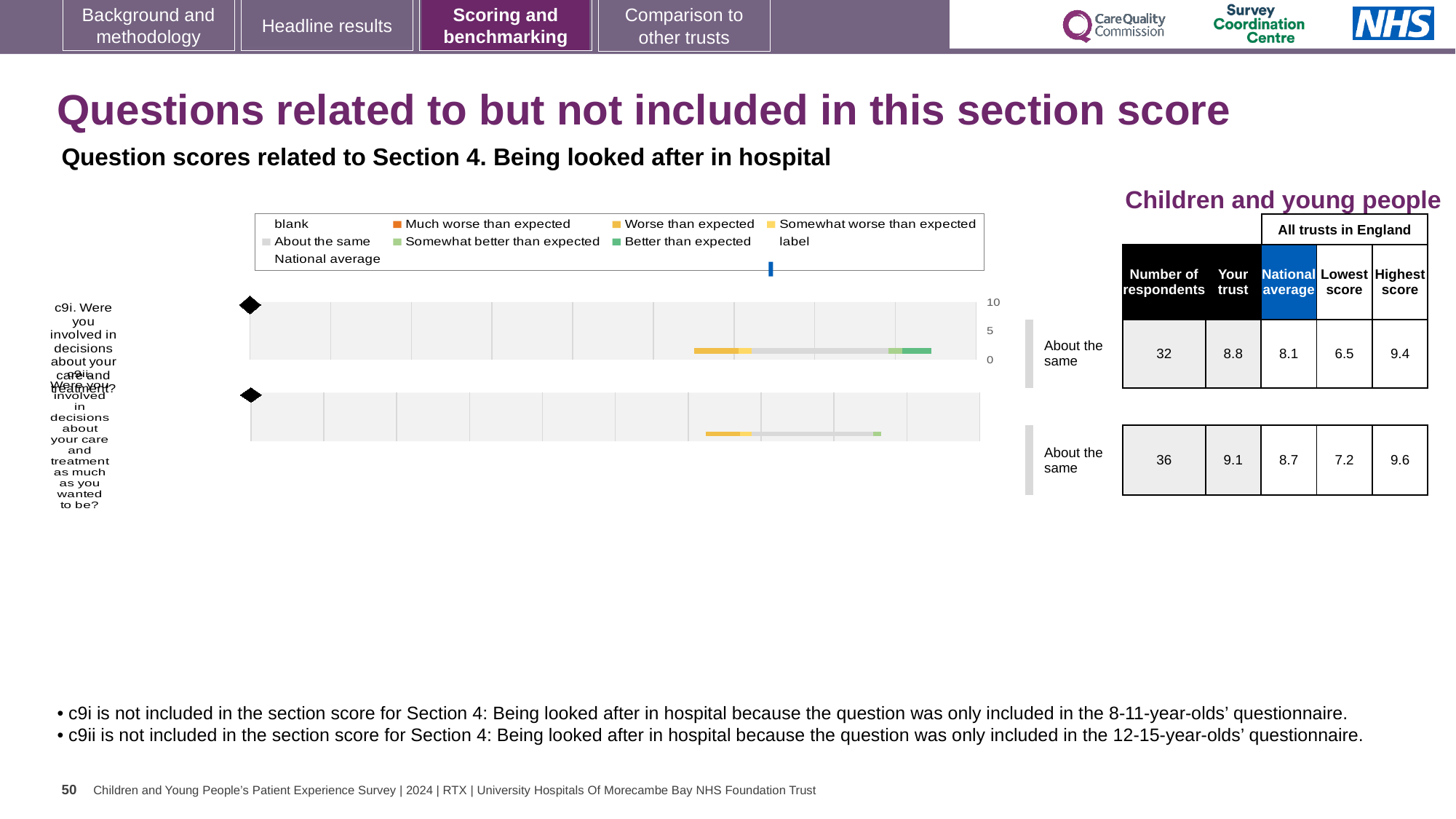
What is the 'Your trust' score for question c9i? 8.8 What is the highest score across all trusts in England for question c9ii? 9.6 How many questions (bars) are plotted in the chart area? 2 Which question has the higher 'Your trust' score, c9i or c9ii? c9ii What type of chart is used to show the question scores for c9i and c9ii? bar chart How many respondents answered question c9i? 32 What benchmark category label is shown next to the c9i bar? About the same What is the difference between the highest and lowest trust scores for question c9i? 2.9 What is the national average score for question c9ii? 8.7 How many entries does the chart legend list? 9 What is the difference between the 'Your trust' score and the national average for c9ii? 0.4